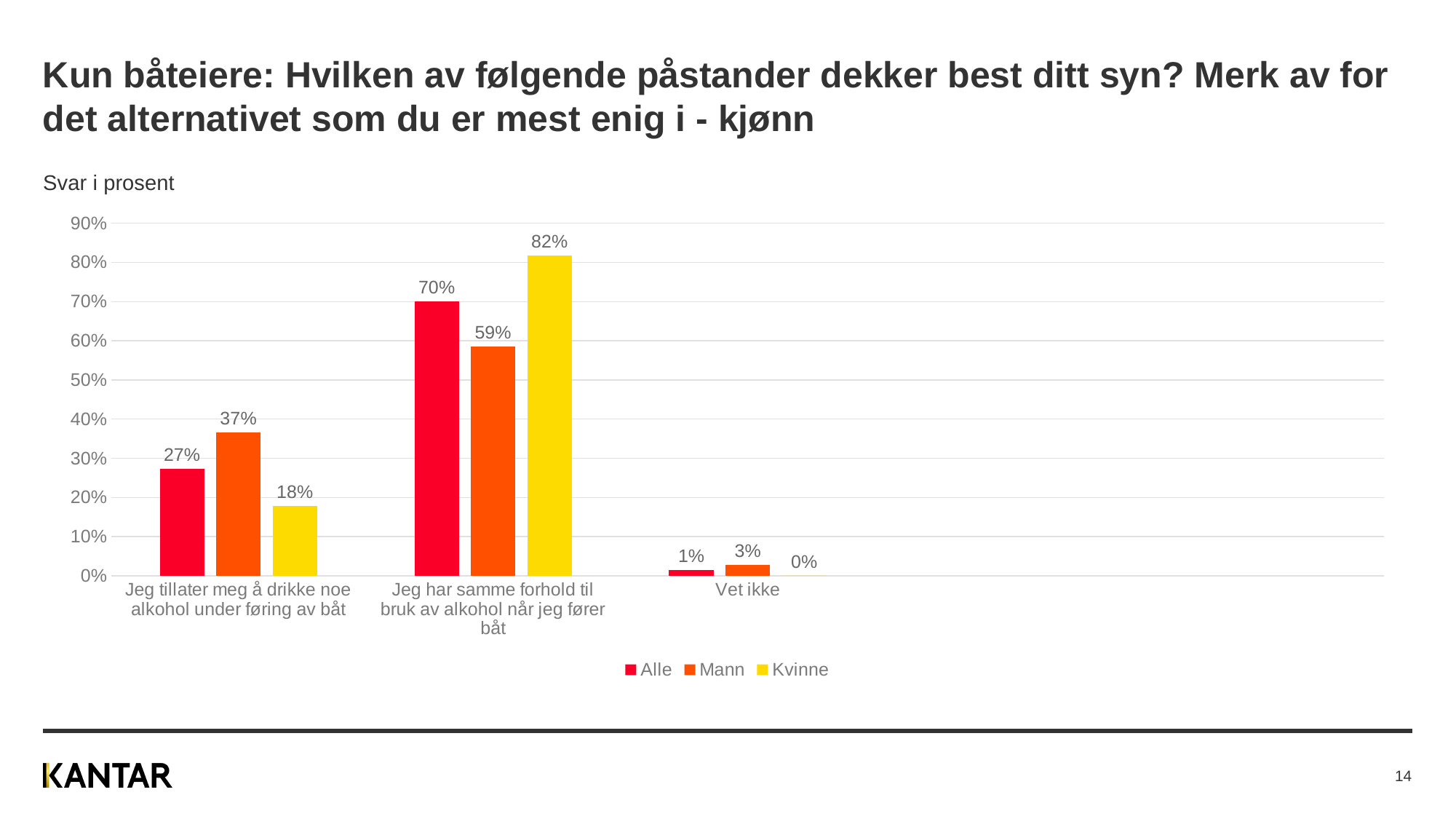
Is the value for Alle in the category "Jeg har samme forhold til bruk av alkohol når jeg fører båt" greater or less than 60%? greater Which category has the highest value for the Alle series? Jeg har samme forhold til bruk av alkohol når jeg fører båt How many series does the legend list? 3 What is the value for Mann in the category "Jeg tillater meg å drikke noe alkohol under føring av båt"? 37% Which is larger in the category "Jeg tillater meg å drikke noe alkohol under føring av båt": the value for Mann or the value for Kvinne? Mann What is the difference between the Kvinne and Mann values in the category "Jeg har samme forhold til bruk av alkohol når jeg fører båt"? 23% What colour are the bars for the Kvinne series? Yellow What is the value for Alle in the category "Vet ikke"? 1% What is the value for Kvinne in the category "Jeg har samme forhold til bruk av alkohol når jeg fører båt"? 82% How many categories are shown on the x axis? 3 Which series has the lowest value in the category "Vet ikke"? Kvinne What kind of chart is shown on the slide? Bar chart